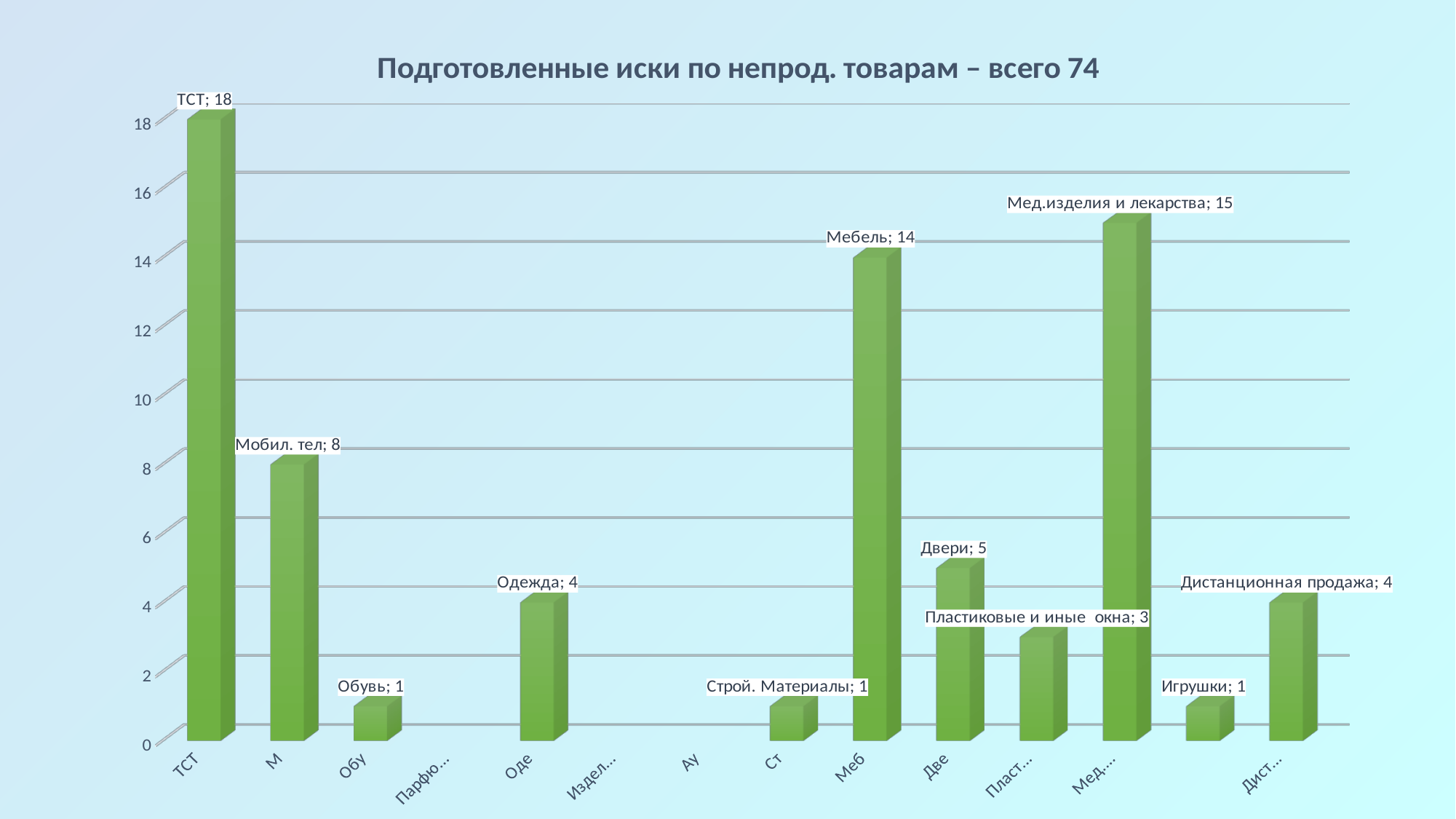
What is the title of the chart? Подготовленные иски по непрод. товарам – всего 74 Which is larger, the value for Мебель or the value for Мед.изделия и лекарства? Мед.изделия и лекарства What is the value for Дистанционная продажа? 4 What is the value for Мед.изделия и лекарства? 15 What is the difference between the values for ТСТ and Мед.изделия и лекарства? 3 What is the value for Мебель? 14 What kind of chart is shown on the slide? Bar chart What is the value for Пластиковые и иные окна? 3 What is the difference between the values for Мебель and Мобил. тел? 6 Which category has the highest value? ТСТ What is the value for Мобил. тел? 8 What is the value for ТСТ? 18